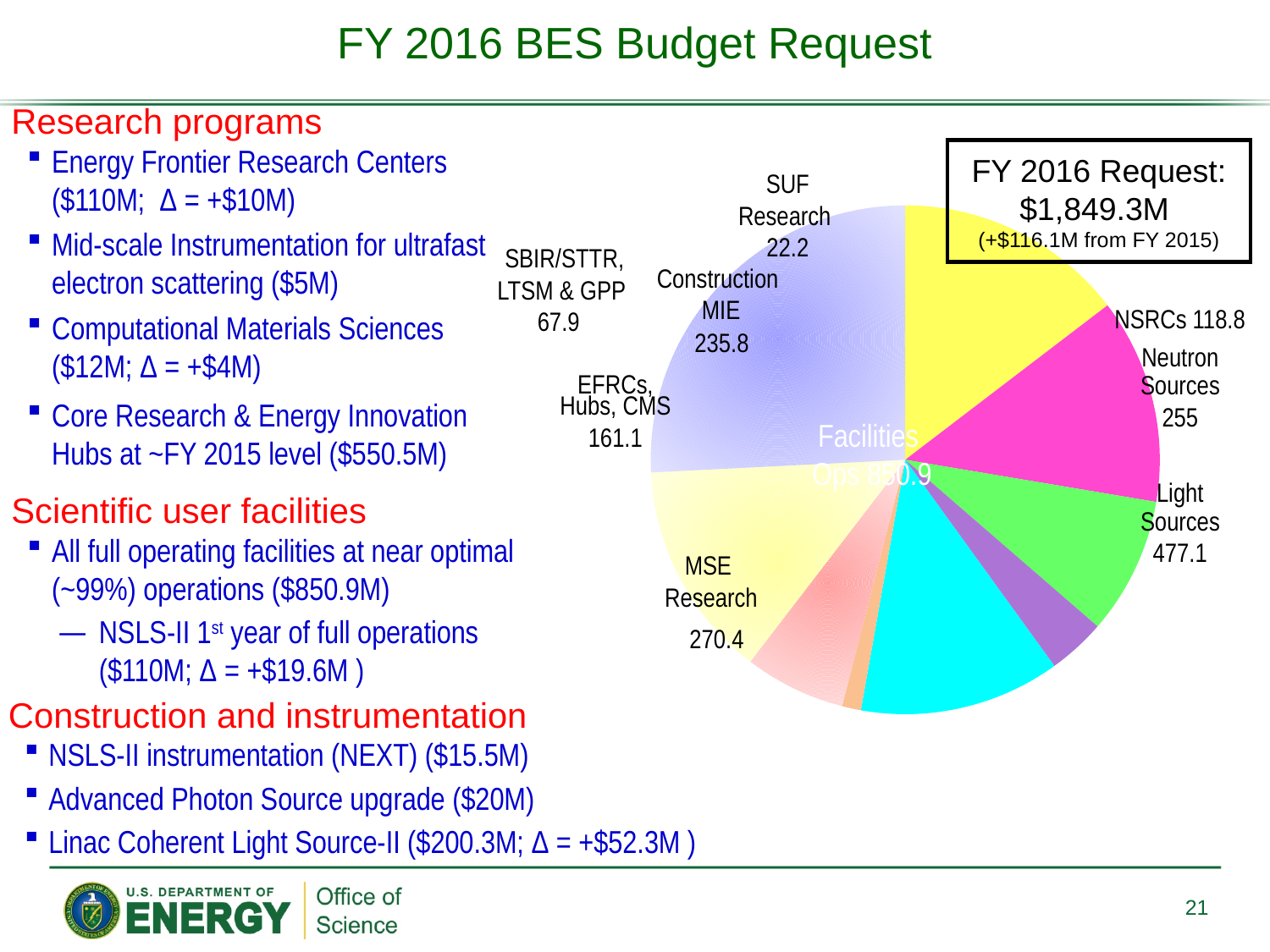
What value is shown for Construction MIE in the pie chart? 235.8 What value is shown for MSE Research in the pie chart? 270.4 What value is shown for EFRCs, Hubs, CMS in the pie chart? 161.1 Which labeled slice in the pie chart has the smallest value? SUF Research Which is larger in the pie chart, MSE Research or Construction MIE? MSE Research What value is shown for Light Sources in the pie chart? 477.1 What kind of chart is shown on the slide? Pie chart What value is shown for Neutron Sources in the pie chart? 255 What value is shown for SBIR/STTR, LTSM & GPP in the pie chart? 67.9 What value is shown for SUF Research in the pie chart? 22.2 What is the difference between the Light Sources value and the Neutron Sources value in the pie chart? 222.1 What value is shown for NSRCs in the pie chart? 118.8